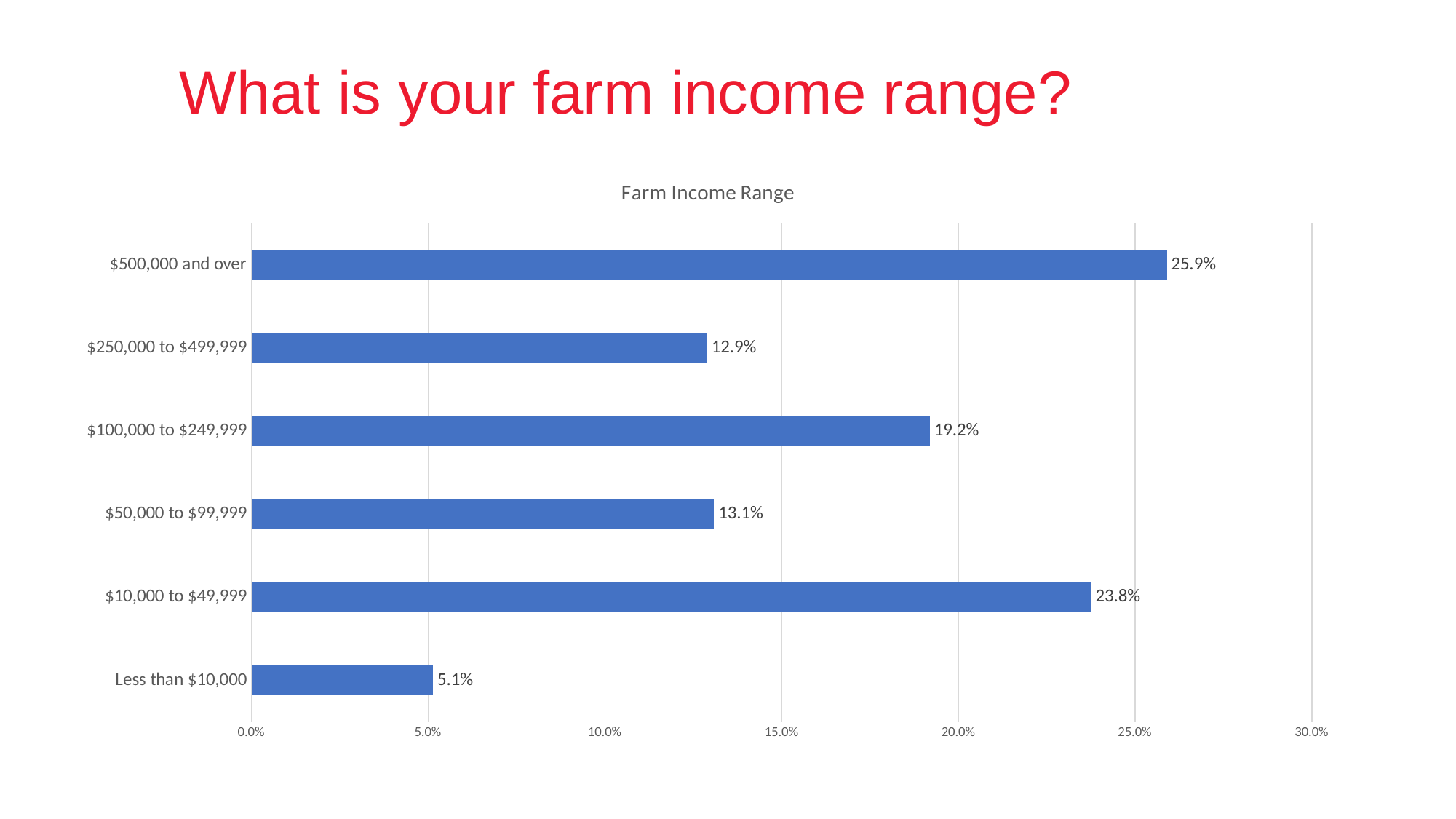
What kind of chart is shown on the slide? bar chart What is the difference between the values for $500,000 and over and $10,000 to $49,999? 2.1% What is the value for $500,000 and over? 25.9% What is the value for $10,000 to $49,999? 23.8% Is the value for $50,000 to $99,999 greater or less than 15.0%? less What is the value for $100,000 to $249,999? 19.2% How many income range categories are shown in the chart? 6 Which income range has the lowest value? Less than $10,000 What is the title of the chart? Farm Income Range Which income range has the highest value? $500,000 and over What is the value for Less than $10,000? 5.1% Which is larger, the value for $100,000 to $249,999 or the value for $250,000 to $499,999? $100,000 to $249,999